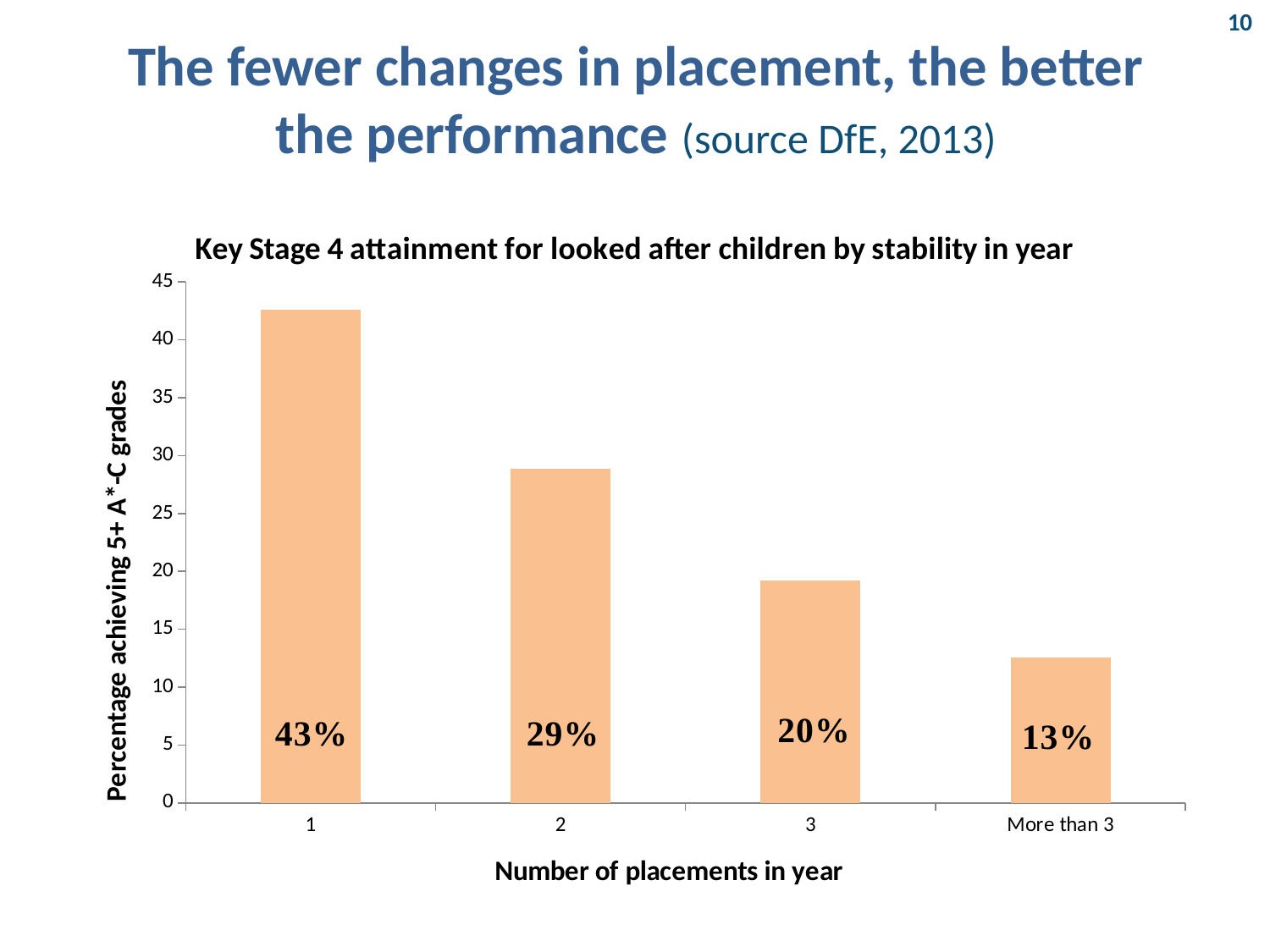
Do the values rise or fall as the number of placements increases along the x axis? Fall What kind of chart is shown on the slide? Bar chart Is the value for 2 placements greater or less than 30? less What is the value shown for 'More than 3' placements in year? 13% What percentage of looked after children with 1 placement in the year achieved 5+ A*-C grades? 43% What is the difference in percentage points between 1 placement and More than 3 placements? 30 What is the value shown for 3 placements in year? 20% How many categories are shown on the x axis? 4 What is the value shown for 2 placements in year? 29% Which number of placements has the lowest percentage achieving 5+ A*-C grades? More than 3 Which is larger: the value for 2 placements or the value for 3 placements? 2 placements Which number of placements has the highest percentage achieving 5+ A*-C grades? 1